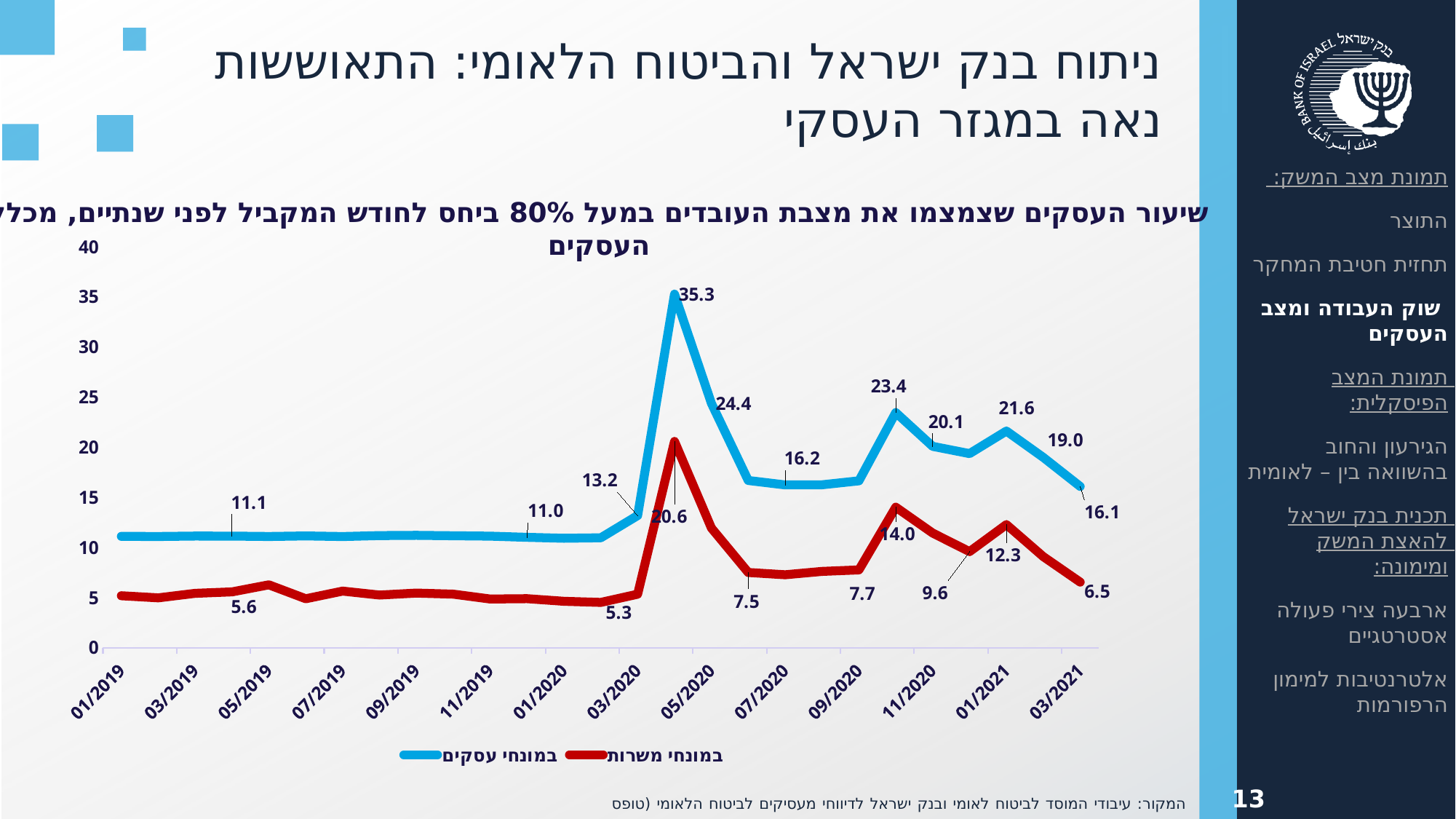
What is the highest labelled value of the red series (במונחי משרות)? 20.6 Which series has the higher value at 03/2021, במונחי עסקים or במונחי משרות? במונחי עסקים What kind of chart is shown on the slide? line chart What is the difference between the peak values of the blue series (35.3) and the red series (20.6)? 14.7 Is the value of the blue series (במונחי עסקים) at 01/2019 greater or less than 15? less What is the value of the red series (במונחי משרות) at 03/2021? 6.5 What is the value of the blue series (במונחי עסקים) at 03/2019? 11.1 What is the highest labelled value of the blue series (במונחי עסקים)? 35.3 How many series does the legend list? 2 Which colour represents the series במונחי משרות in the legend? red What is the value of the blue series (במונחי עסקים) at 03/2021? 16.1